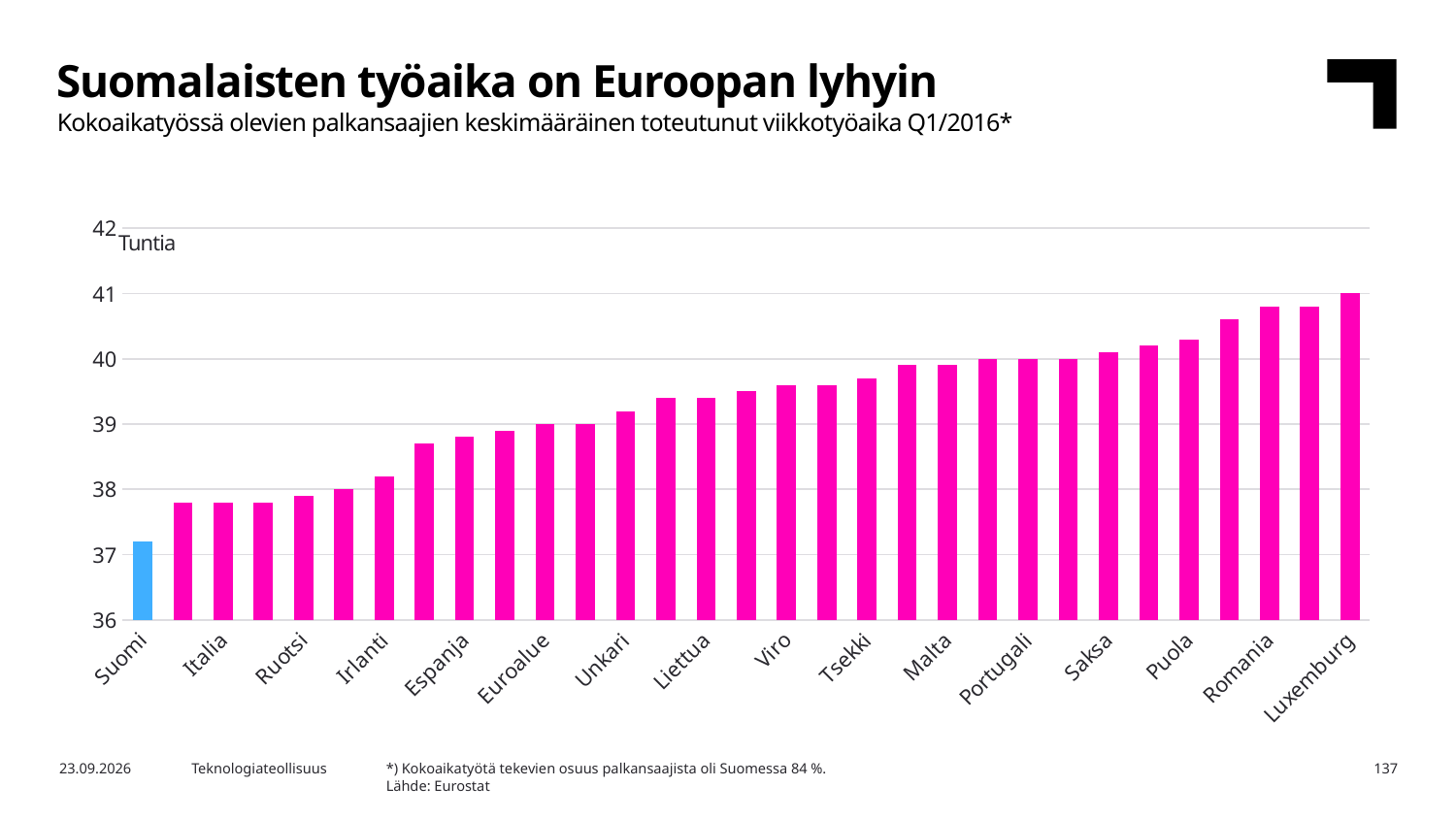
Is the value for Suomi greater or less than 38? less Which country has the highest average weekly working time in the chart? Luxemburg Which bar is shown in a different colour (blue) from the others? Suomi Is the value for Romania greater or less than 40? greater Which has a higher value, Suomi or Italia? Italia Do the bar values rise or fall from left to right along the x axis? rise Is the value for Viro greater or less than 39? greater Which country has the lowest average weekly working time in the chart? Suomi What kind of chart is shown on the slide? bar chart Which has a higher value, Romania or Irlanti? Romania